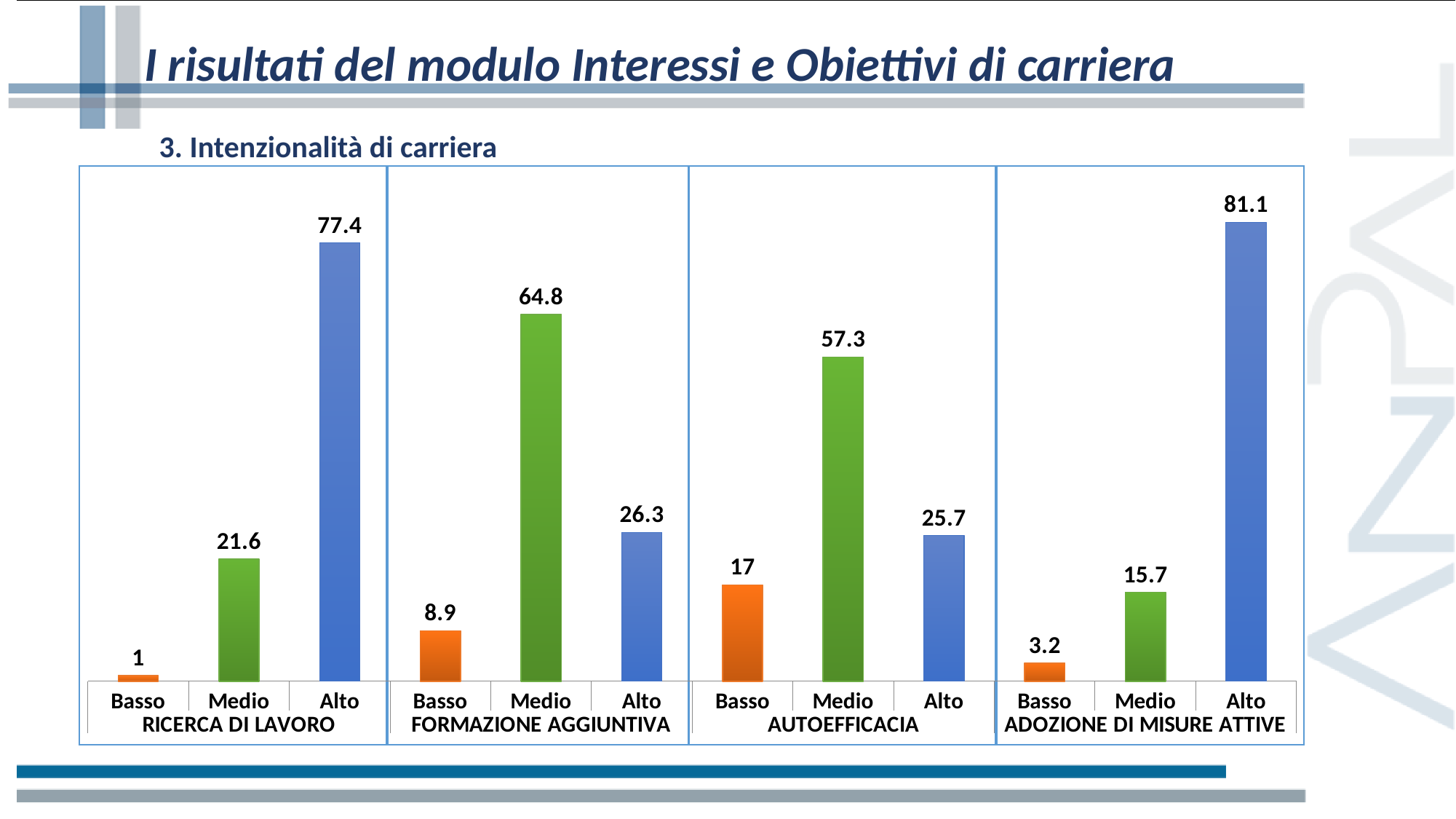
Which bar has the highest value in the whole chart? Alto in ADOZIONE DI MISURE ATTIVE (81.1) What is the difference between Basso in AUTOEFFICACIA and Basso in FORMAZIONE AGGIUNTIVA? 8.1 What kind of chart is shown on the slide? Bar chart What is the value for Alto in the RICERCA DI LAVORO group? 77.4 What is the difference between Alto and Medio in the RICERCA DI LAVORO group? 55.8 Within the AUTOEFFICACIA group, which level has the highest value? Medio Which bar has the lowest value in the whole chart? Basso in RICERCA DI LAVORO (1) What is the value for Medio in the FORMAZIONE AGGIUNTIVA group? 64.8 What is the value for Medio in the ADOZIONE DI MISURE ATTIVE group? 15.7 How many category groups are shown on the x axis? 4 Which is larger: Alto in FORMAZIONE AGGIUNTIVA or Alto in AUTOEFFICACIA? Alto in FORMAZIONE AGGIUNTIVA What is the value for Basso in the AUTOEFFICACIA group? 17